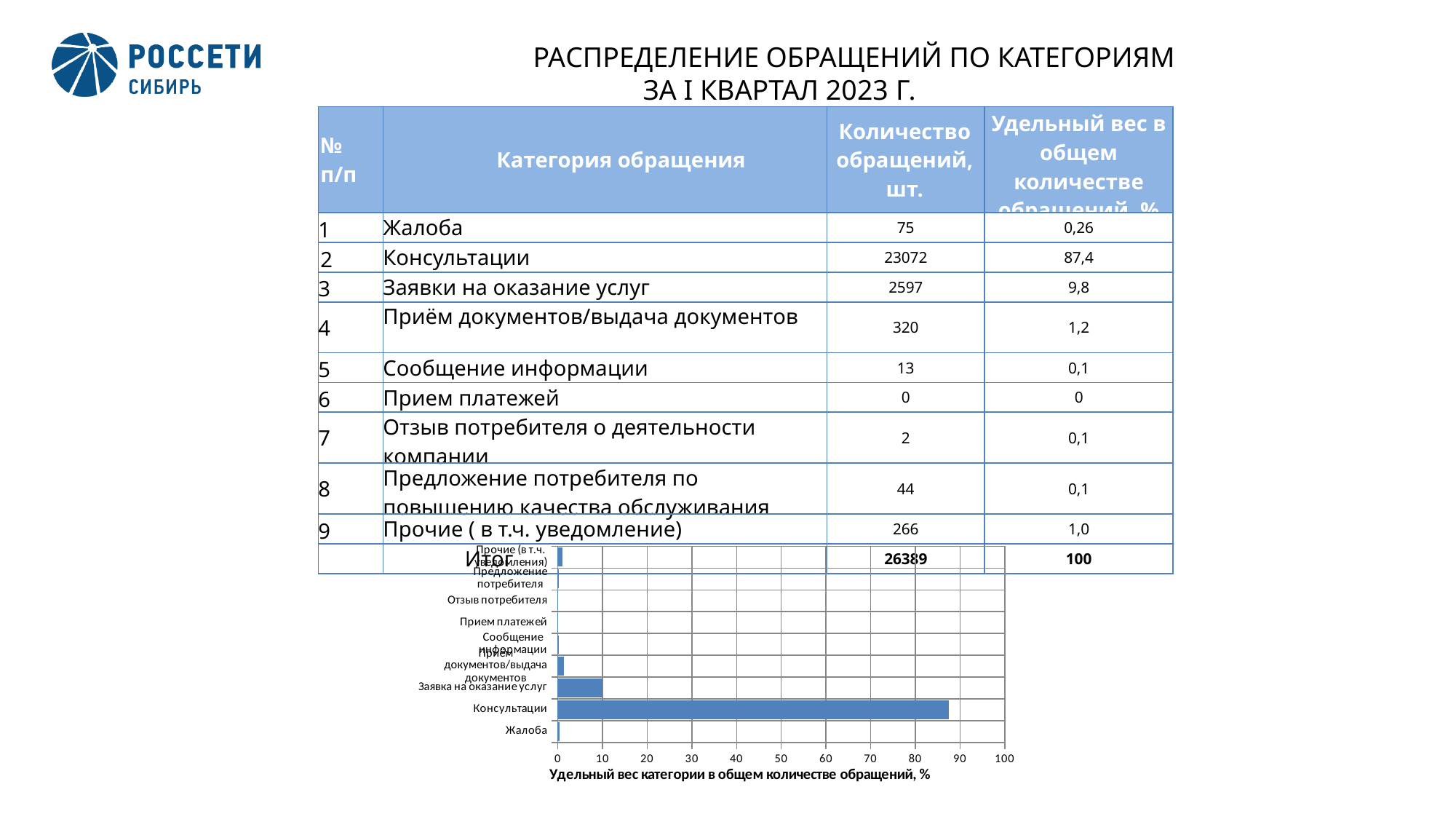
Is the value for Приём документов/выдача документов on the bar chart greater or less than 10? less On the bar chart, which is larger: Заявка на оказание услуг or Жалоба? Заявка на оказание услуг What is the maximum value shown on the horizontal axis of the bar chart? 100 What is the title of the horizontal axis of the bar chart? Удельный вес категории в общем количестве обращений, % How many categories are plotted on the bar chart? 9 What kind of chart is shown at the bottom of the slide? bar chart On the bar chart, which is larger: Консультации or Заявка на оказание услуг? Консультации Which category has the highest value on the bar chart? Консультации Is the value for Жалоба on the bar chart greater or less than 10? less Is the value for Заявка на оказание услуг on the bar chart greater or less than 20? less